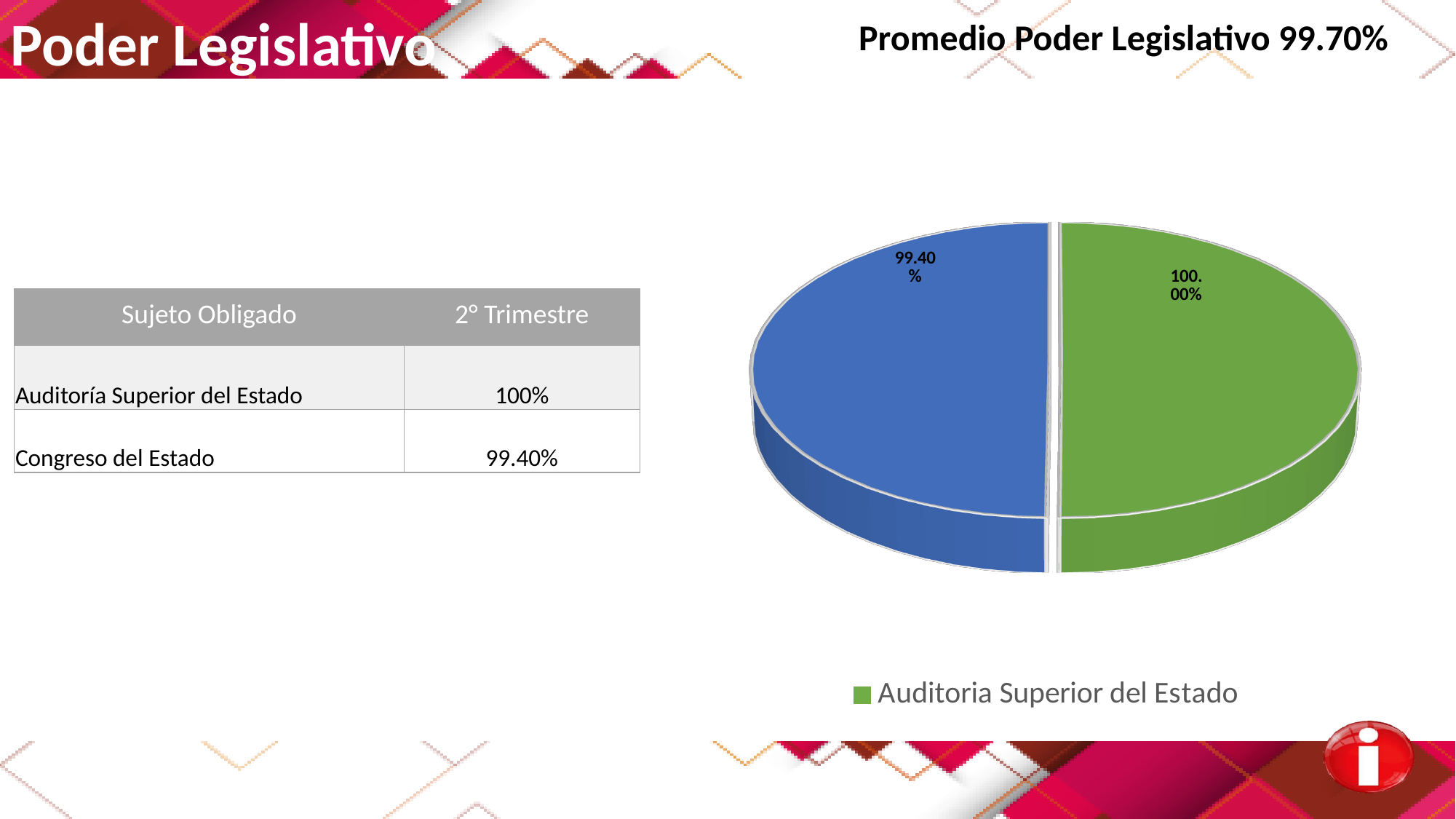
What is the value for Auditoria Superior del Estado in the pie chart? 100.00% What kind of chart is shown on the slide? Pie chart Which slice of the pie chart has the larger printed value, the green one or the blue one? Green What is the difference between the values printed on the green slice and the blue slice of the pie chart? 0.60% Which entry appears in the pie chart's legend? Auditoria Superior del Estado What colour is the slice for Auditoria Superior del Estado in the pie chart? Green What value is printed on the green slice of the pie chart? 100.00% What value is printed on the blue slice of the pie chart? 99.40% How many entries does the pie chart's legend list? 1 How many slices does the pie chart have? 2 Which slice of the pie chart has the lowest printed value? The blue slice (99.40%)